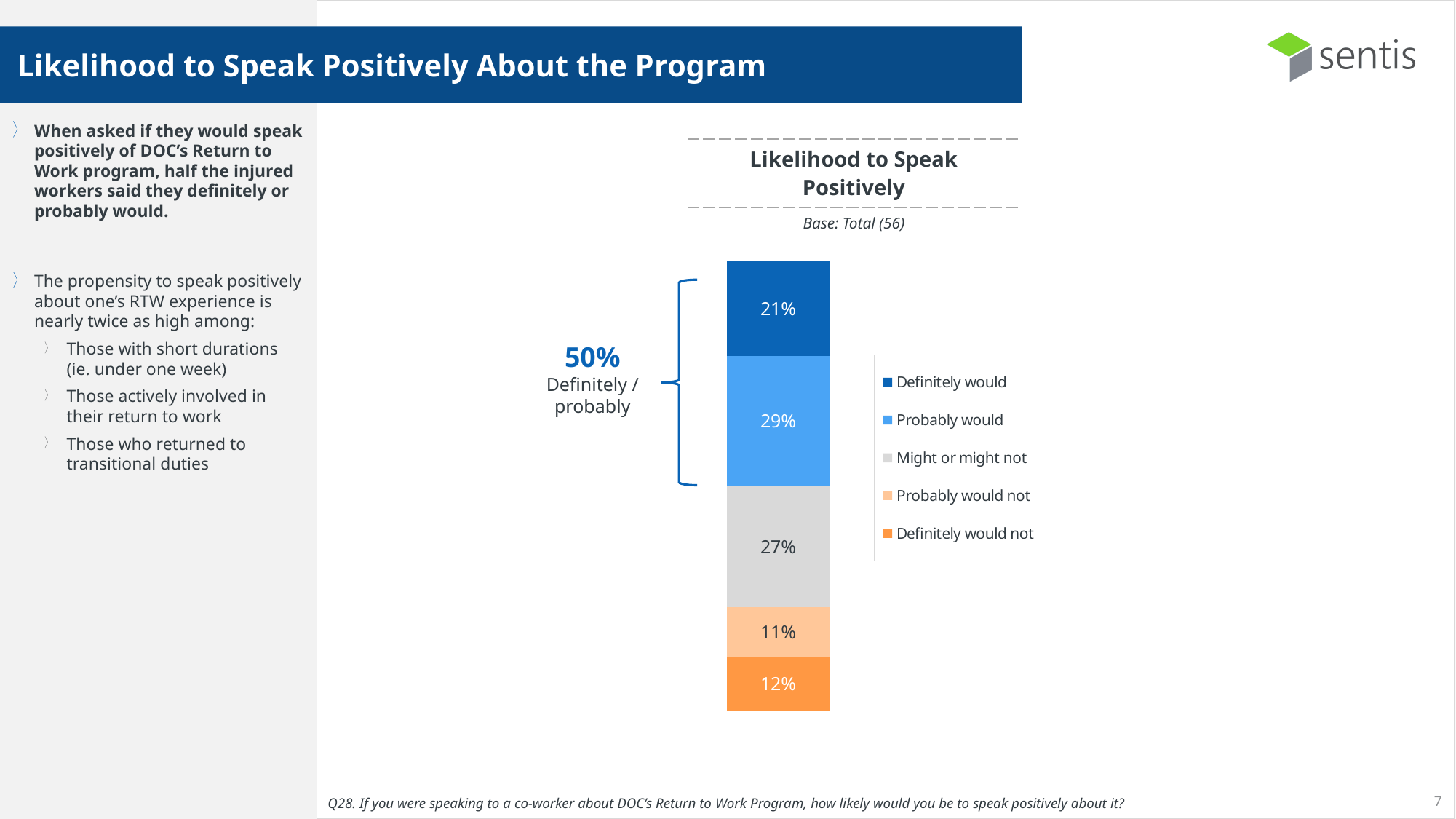
What percentage of respondents said they definitely would speak positively about the program? 21% How many series does the chart legend list? 5 What is the difference between the 'Probably would' and 'Definitely would' percentages? 8% What is the value for 'Might or might not'? 27% What percentage said they definitely would not speak positively? 12% Which is larger, the 'Might or might not' share or the 'Definitely would' share? Might or might not What type of chart is shown on the slide? Stacked bar chart What percentage of respondents said they probably would speak positively? 29% What is the base size shown under the chart title? Total (56) What is the combined percentage of 'Definitely would' and 'Probably would' shown on the chart? 50% Which response category has the largest share in the stacked bar? Probably would Which response category has the smallest share in the stacked bar? Probably would not